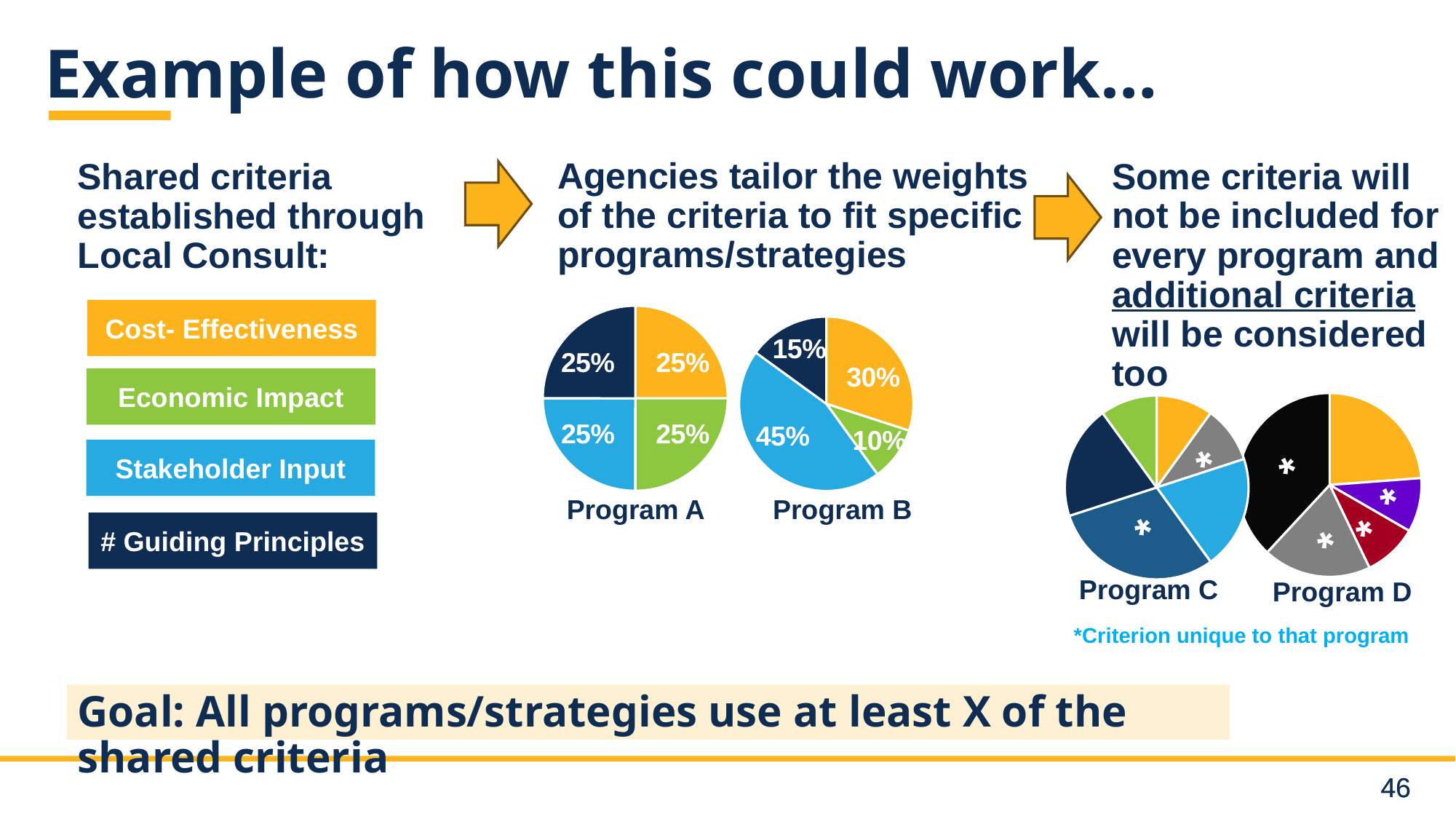
How many slices does the Program C pie chart have? 6 According to the note below the Program C and Program D pie charts, what does an asterisk on a slice indicate? Criterion unique to that program In the Program B pie chart, what percentage is shown on the dark navy slice? 15% In the Program B pie chart, what is the largest percentage shown? 45% In the Program B pie chart, what percentage is shown on the orange slice? 30% In the Program B pie chart, which is larger: the orange slice or the green slice? The orange slice (30%) How many slices does the Program D pie chart have? 5 In the Program B pie chart, what is the smallest percentage shown? 10% What kind of charts are used for Program A, Program B, Program C and Program D? Pie charts How many slices does the Program A pie chart have? 4 In the Program B pie chart, what is the difference between the largest slice (45%) and the orange slice (30%)? 15 percentage points In the Program A pie chart, what percentage does each slice have? 25%